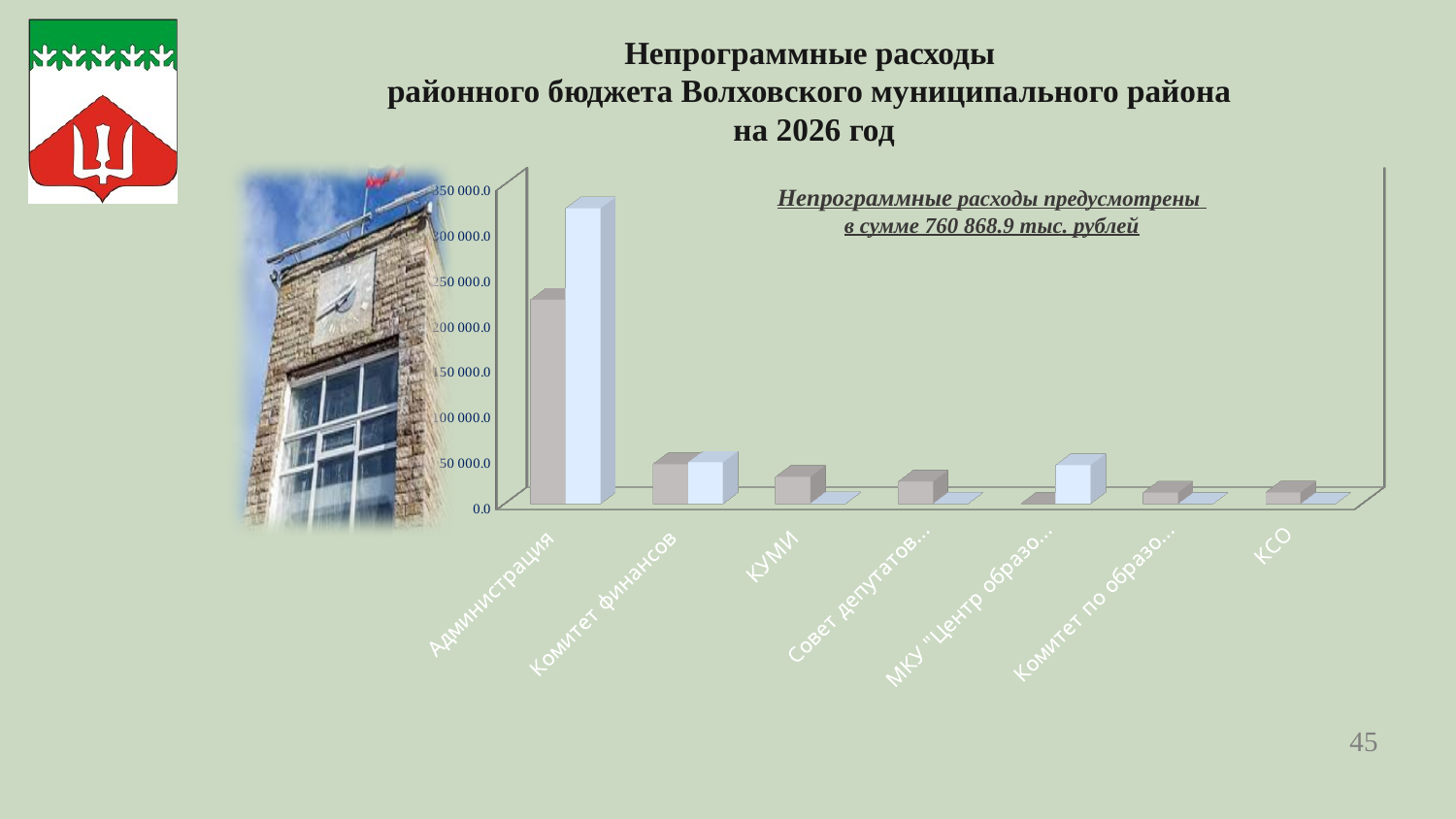
Is the grey bar for Администрация greater or less than 200 000.0? greater Which has the larger grey bar: Администрация or Комитет финансов? Администрация Is the light blue bar for МКУ "Центр образо..." greater or less than 100 000.0? less Is the light blue bar for Администрация greater or less than 300 000.0? greater What kind of chart is shown on the slide? bar chart What total sum of non-programme expenditures is stated in the text on the chart? 760 868.9 тыс. рублей How many categories are shown on the x axis of the chart? 7 Which category has the tallest bars in the chart? Администрация How many bars (series) are plotted for each category in the chart? 2 For which year does the slide title say the non-programme expenditures are shown? 2026